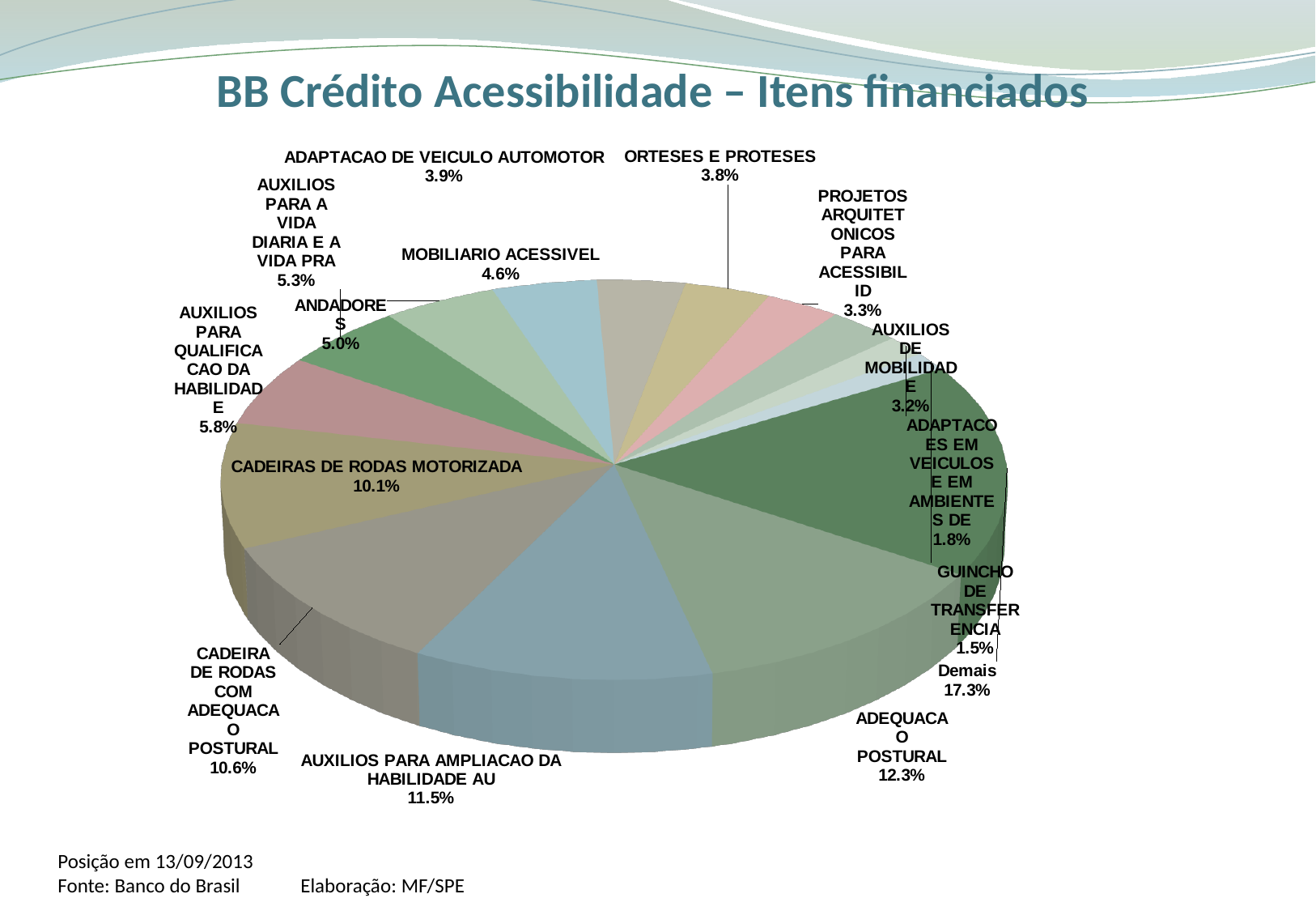
Which slice has the smallest share of the pie? GUINCHO DE TRANSFERENCIA What percentage is shown for ORTESES E PROTESES? 3.8% What is the title of the chart on the slide? BB Crédito Acessibilidade – Itens financiados Which is larger, CADEIRA DE RODAS COM ADEQUACAO POSTURAL or AUXILIOS PARA AMPLIACAO DA HABILIDADE AU? AUXILIOS PARA AMPLIACAO DA HABILIDADE AU Which slice has the largest share of the pie? Demais What kind of chart is shown on the slide? pie chart How many slices does the pie chart have? 15 What share of the pie does ADEQUACAO POSTURAL represent? 12.3% What percentage is shown for MOBILIARIO ACESSIVEL? 4.6% What percentage is shown for ANDADORES? 5.0% What percentage is shown for CADEIRAS DE RODAS MOTORIZADA? 10.1% What is the difference in percentage points between Demais and ADEQUACAO POSTURAL? 5.0